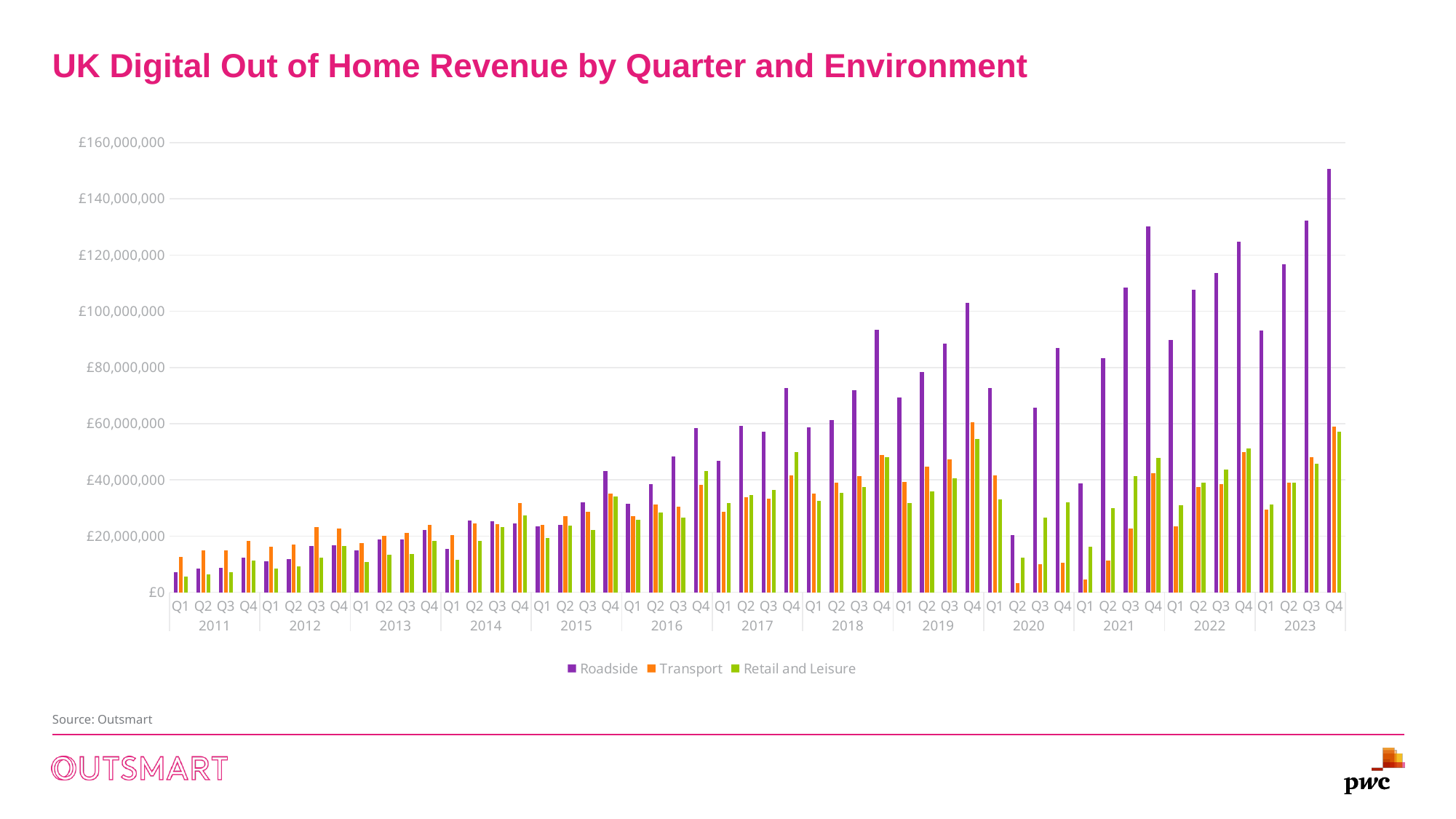
What kind of chart is shown on the slide? Bar chart Do the Roadside values rise or fall from Q1 2023 to Q4 2023? Rise Which series is shown in purple in the legend? Roadside Is the Roadside value for Q4 2023 greater or less than £140,000,000? greater In which quarter does Roadside reach its highest value? Q4 2023 How many years are shown along the x axis? 13 How many series does the legend list? 3 Which series has the highest bar in Q4 2023? Roadside Is the Roadside value for Q1 2011 greater or less than £20,000,000? less In Q1 2011, which is larger: Roadside or Transport? Transport In which quarter does Transport reach its lowest value? Q2 2020 What is the title of the chart? UK Digital Out of Home Revenue by Quarter and Environment